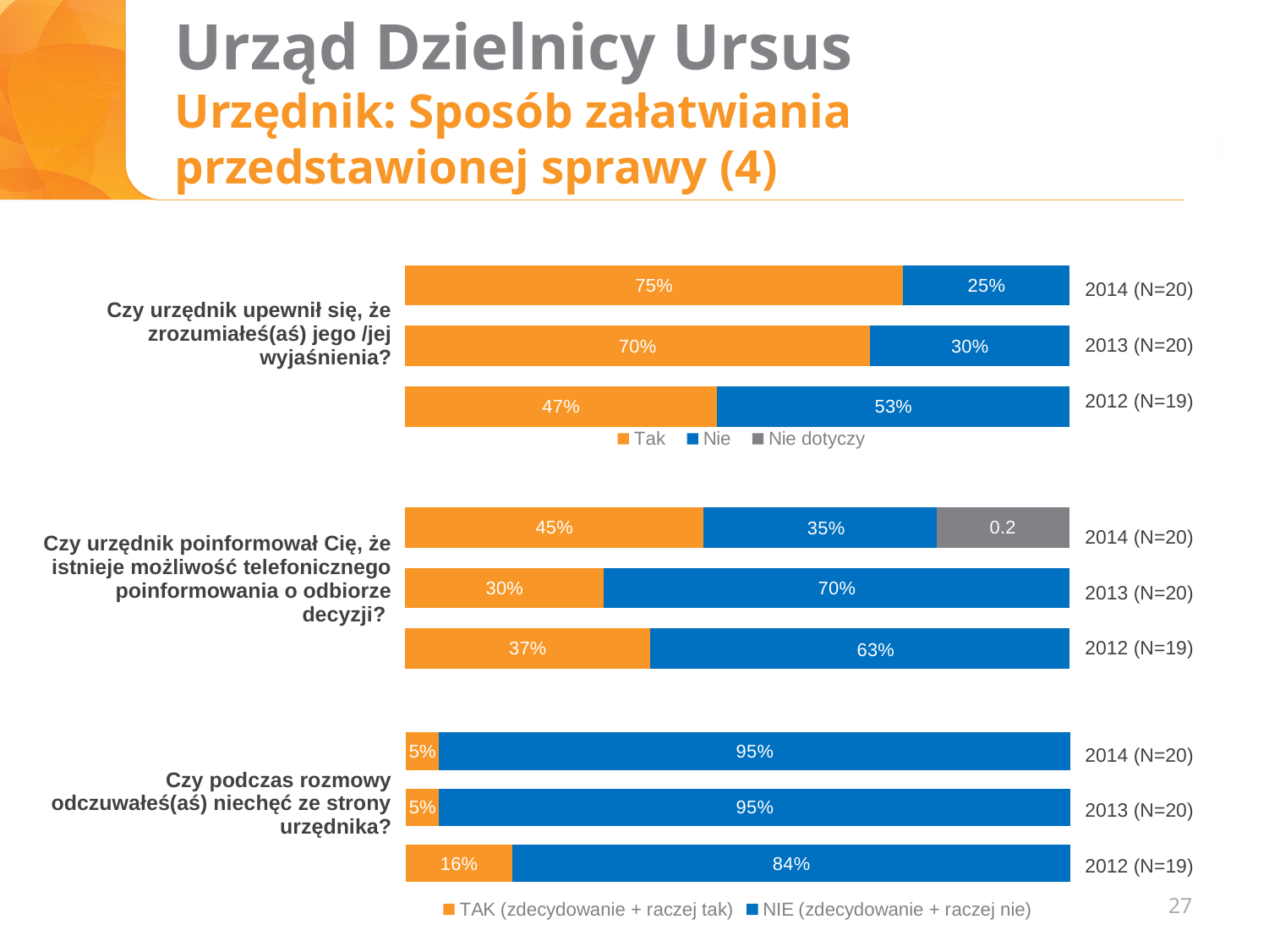
In the bottom chart, is the 'NIE' value for 2014 larger or smaller than the 'NIE' value for 2012? larger In the top chart (Czy urzędnik upewnił się, że zrozumiałeś(aś) jego/jej wyjaśnienia?), what is the 'Tak' value for 2014 (N=20)? 75% In the middle chart, which year has the lowest orange 'Tak' value? 2013 (N=20) In the bottom chart (Czy podczas rozmowy odczuwałeś(aś) niechęć ze strony urzędnika?), what is the 'TAK' value for 2012 (N=19)? 16% In the middle chart, what is the blue 'Nie' value for 2013 (N=20)? 70% What type of chart is used on this slide? Stacked bar chart In the top chart, what is the 'Nie' value for 2012 (N=19)? 53% How many year bars does the bottom chart show? 3 In the top chart, which year has the highest 'Tak' value? 2014 (N=20) In the top chart, what is the difference between the 'Tak' values for 2014 and 2012? 28% In the middle chart (Czy urzędnik poinformował Cię, że istnieje możliwość telefonicznego poinformowania o odbiorze decyzji?), what is the value of the grey segment for 2014 (N=20)? 0.2 How many entries does the legend of the top chart list? 3